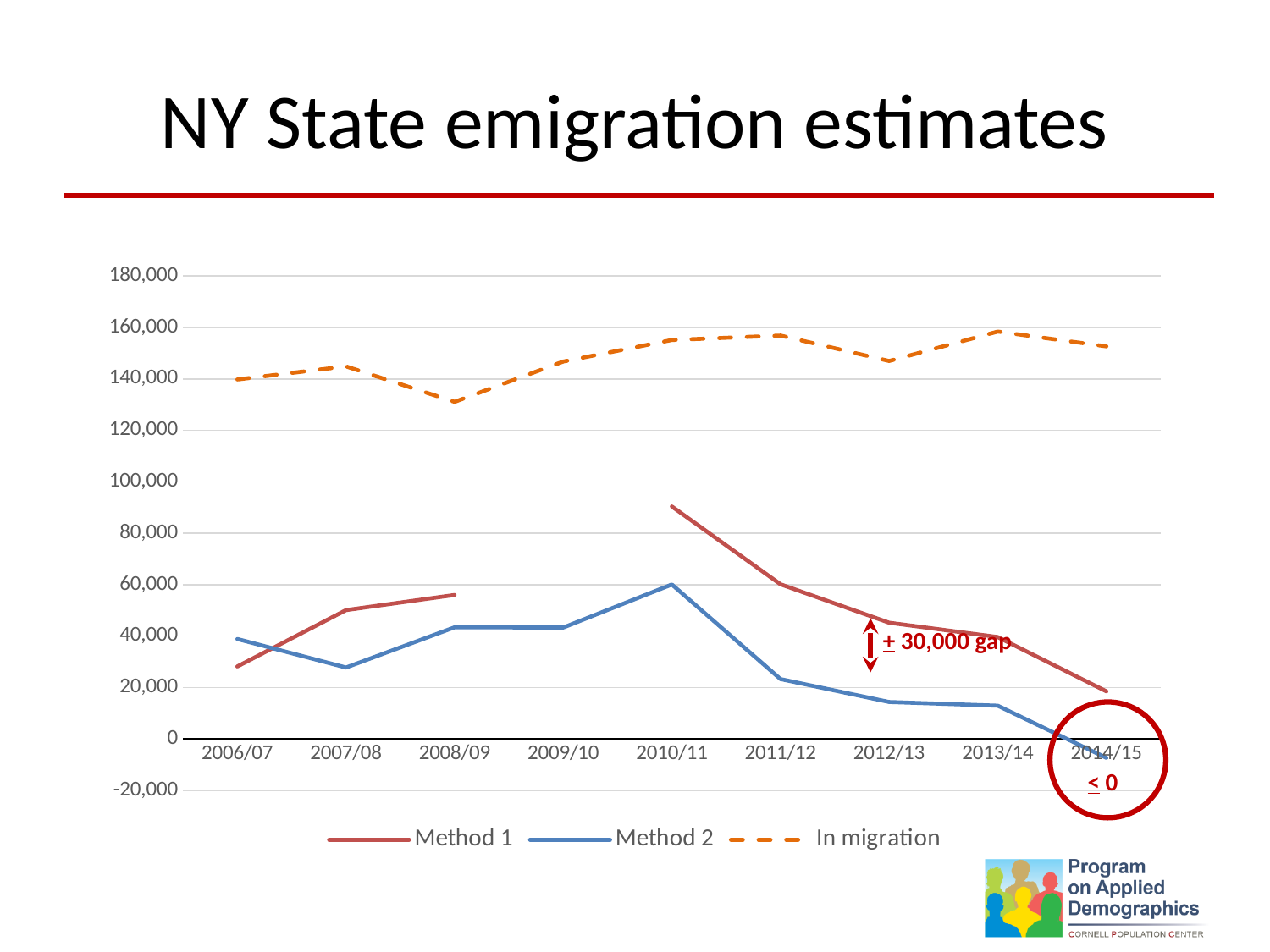
Is the In migration value for 2008/09 greater or less than 140,000? less Is the Method 1 value for 2010/11 greater or less than 80,000? greater Is the Method 2 value for 2014/15 greater or less than 0? less In 2006/07, which is larger, Method 1 or Method 2? Method 2 What is the title of the chart? NY State emigration estimates In 2010/11, which is larger, Method 1 or Method 2? Method 1 How many series does the legend list? 3 Which series is drawn with a dashed line? In migration How many year categories are shown on the x axis? 9 What kind of chart is shown on the slide? line chart Does the Method 1 line rise or fall from 2010/11 to 2014/15? fall In which year does Method 1 reach its highest value? 2010/11